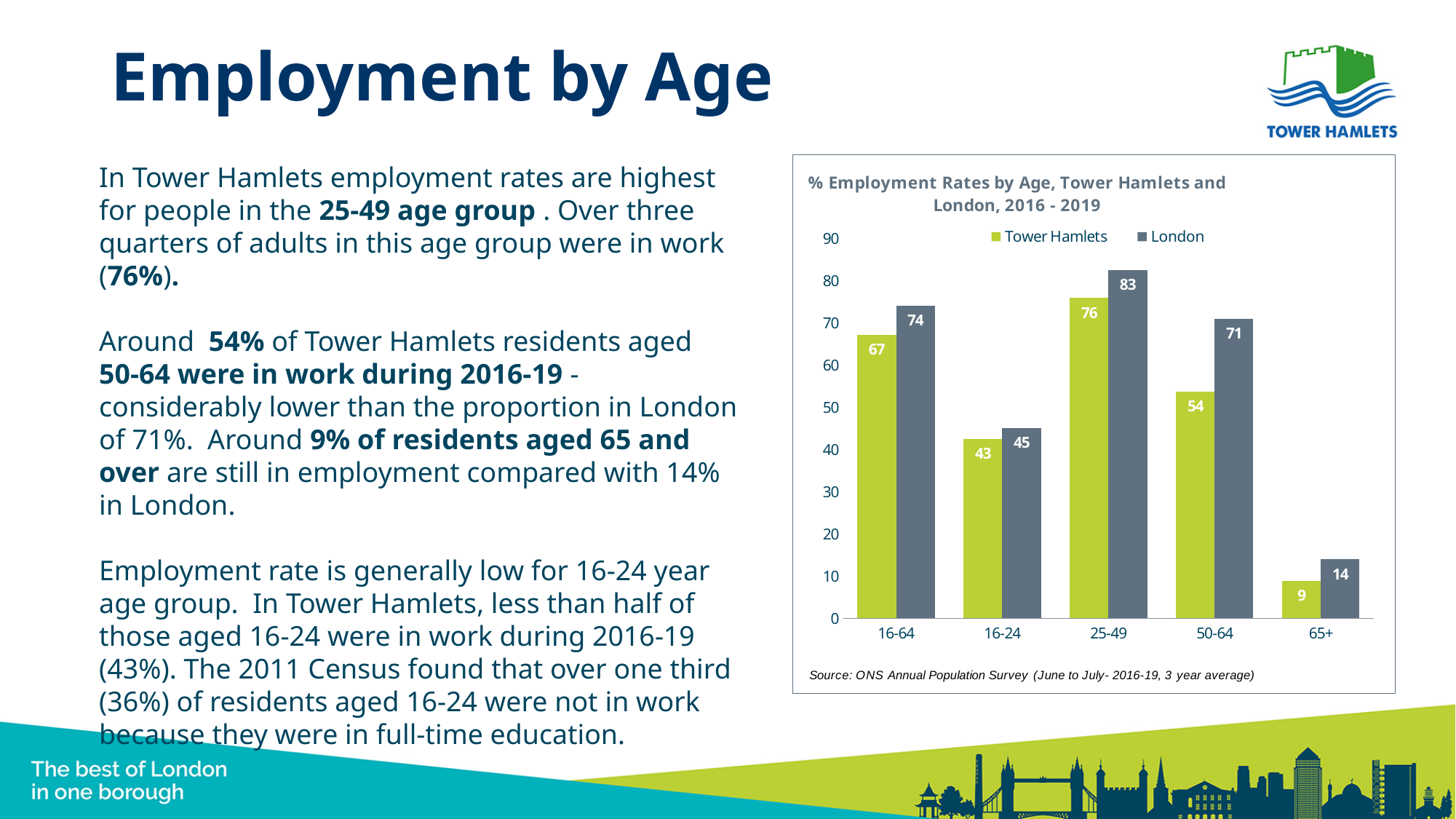
What is the Tower Hamlets employment rate for the 25-49 age group? 76 Which is larger for the 16-24 age group, the Tower Hamlets rate or the London rate? London Which colour represents Tower Hamlets in the chart? green What is the London employment rate for the 50-64 age group? 71 How many series does the legend list? 2 What is the difference between the London and Tower Hamlets employment rates for the 50-64 age group? 17 What kind of chart is shown on the slide? bar chart Which age group has the lowest Tower Hamlets employment rate? 65+ How many age groups are shown on the x axis? 5 Which age group has the highest London employment rate? 25-49 What is the Tower Hamlets employment rate for the 65+ age group? 9 Is the Tower Hamlets value for the 16-64 age group greater or less than 60? greater